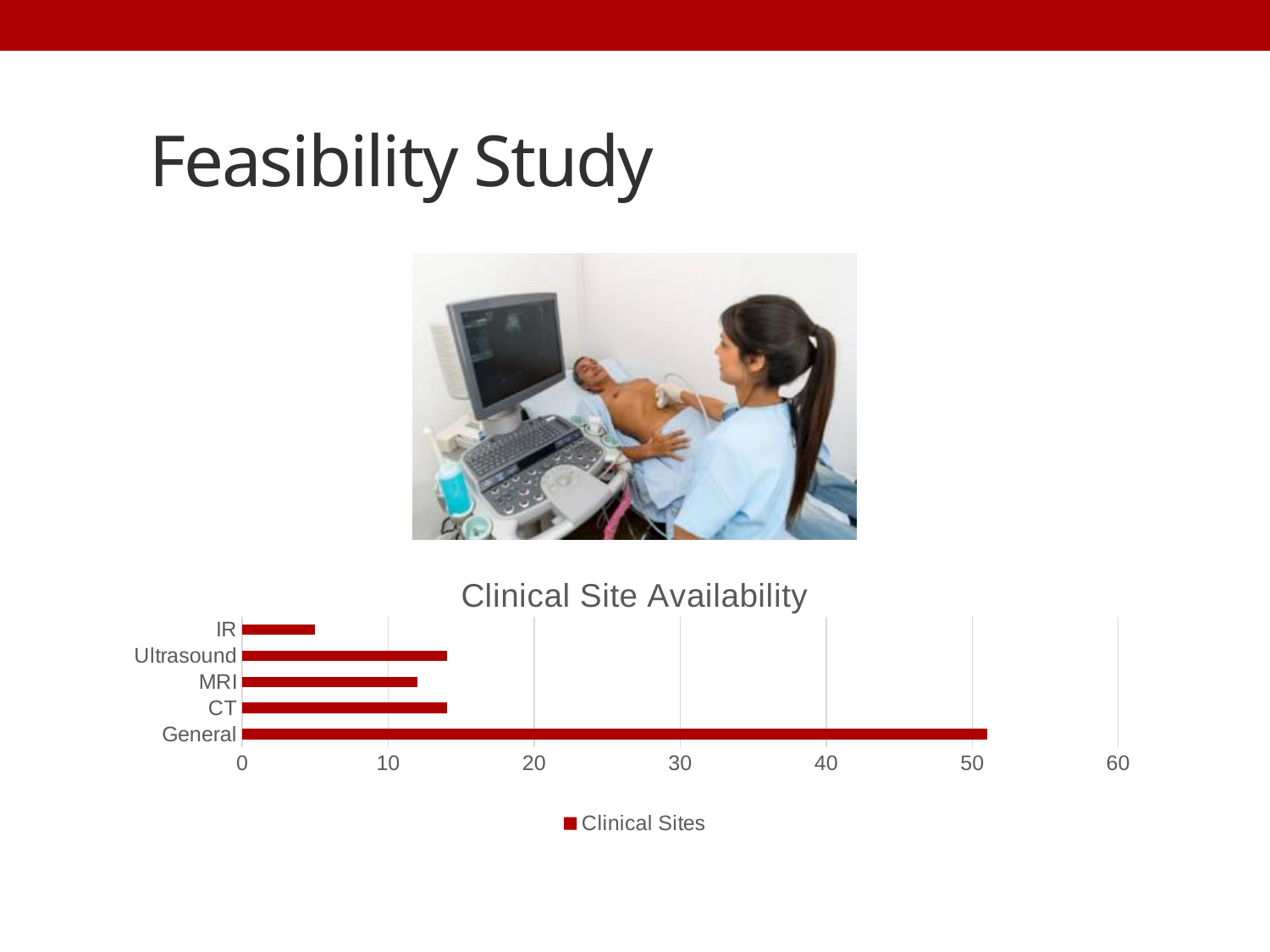
How many series does the legend list? 1 Is the value for IR greater or less than 10? less Which category has the lowest value? IR Which category has the highest value? General Is the value for General greater or less than 40? greater What is the name of the series shown in the legend? Clinical Sites Is the value for Ultrasound greater or less than 20? less What kind of chart is shown on the slide? bar chart What is the title of the chart? Clinical Site Availability How many categories are plotted in the chart? 5 Which has the larger value, MRI or IR? MRI